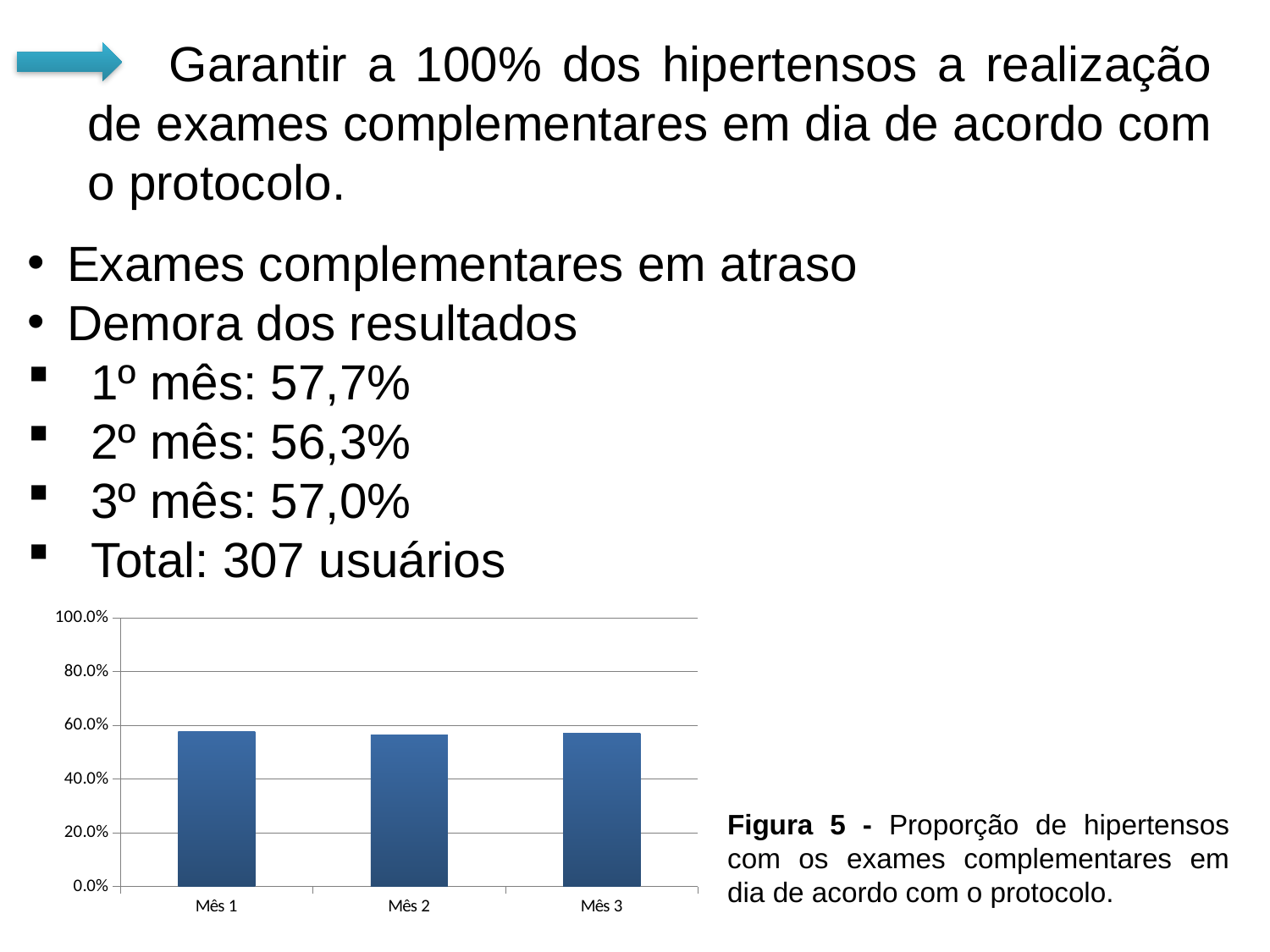
What is the highest value shown on the vertical axis of the chart? 100.0% Is the value for Mês 2 greater or less than 40.0%? greater What kind of chart is shown on the slide? bar chart Is the value for Mês 3 greater or less than 80.0%? less What is the label of the first category on the x axis? Mês 1 Is the value for Mês 1 greater or less than 60.0%? less Do the bar values change substantially from Mês 1 to Mês 3, or stay roughly flat? roughly flat How many categories (months) are plotted on the chart? 3